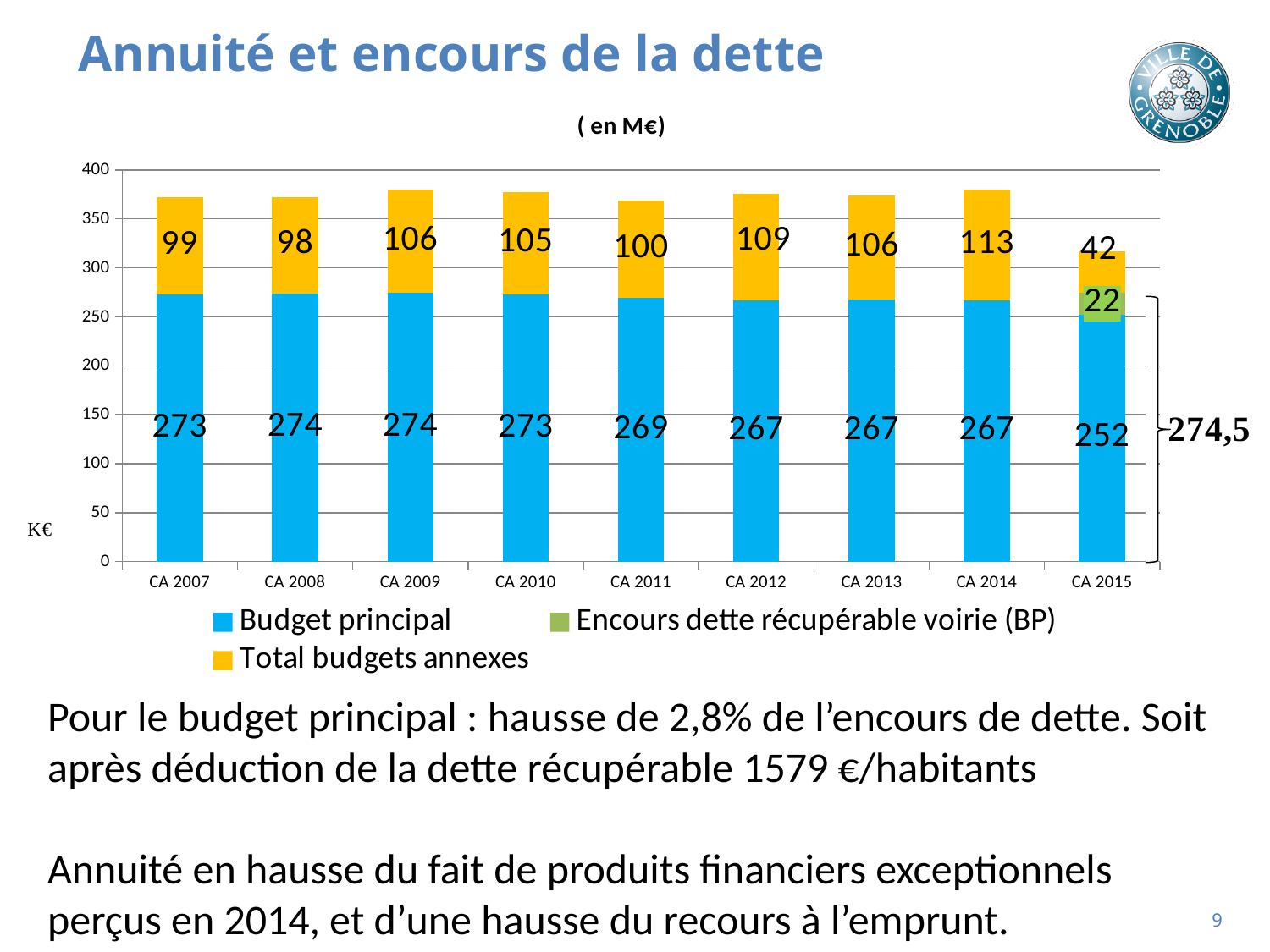
In which year is Budget principal the lowest? CA 2015 What is the total of the stacked bar for CA 2015? 316 How many years (categories) are shown on the x axis? 9 Which series is shown in green in the legend? Encours dette récupérable voirie (BP) In which year is Total budgets annexes the highest? CA 2014 What is the value of Budget principal for CA 2007? 273 What kind of chart is shown on the slide? Stacked bar chart What is the value of Encours dette récupérable voirie (BP) for CA 2015? 22 What is the difference between Budget principal in CA 2007 and in CA 2015? 21 Which is larger: Budget principal for CA 2011 or for CA 2015? CA 2011 What is the value of Total budgets annexes for CA 2014? 113 How many series does the legend list? 3